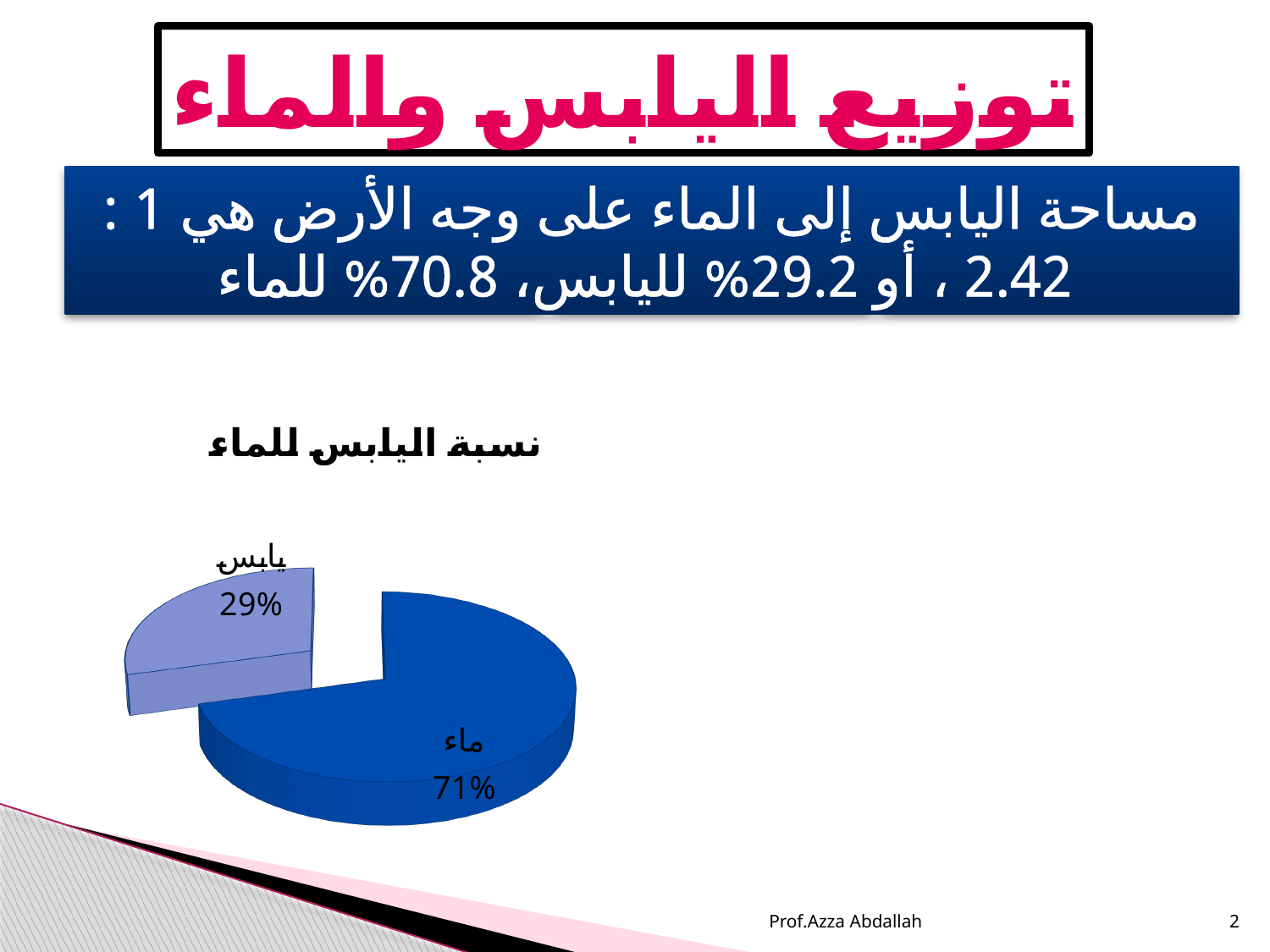
What is the title of the chart on the slide? نسبة اليابس للماء What kind of chart is shown on the slide? pie chart What is the difference in percentage points between the ماء slice and the يابس slice? 42 What percentage does the ماء slice show in the pie chart? 71% Which is larger in the pie chart, ماء or يابس? ماء How many slices does the pie chart have? 2 What percentage does the يابس slice show in the pie chart? 29% Which slice of the pie chart is the largest? ماء Which slice of the pie chart is pulled out (exploded) from the rest? يابس What share of the pie does the يابس slice represent? 29% Which slice of the pie chart is the smallest? يابس